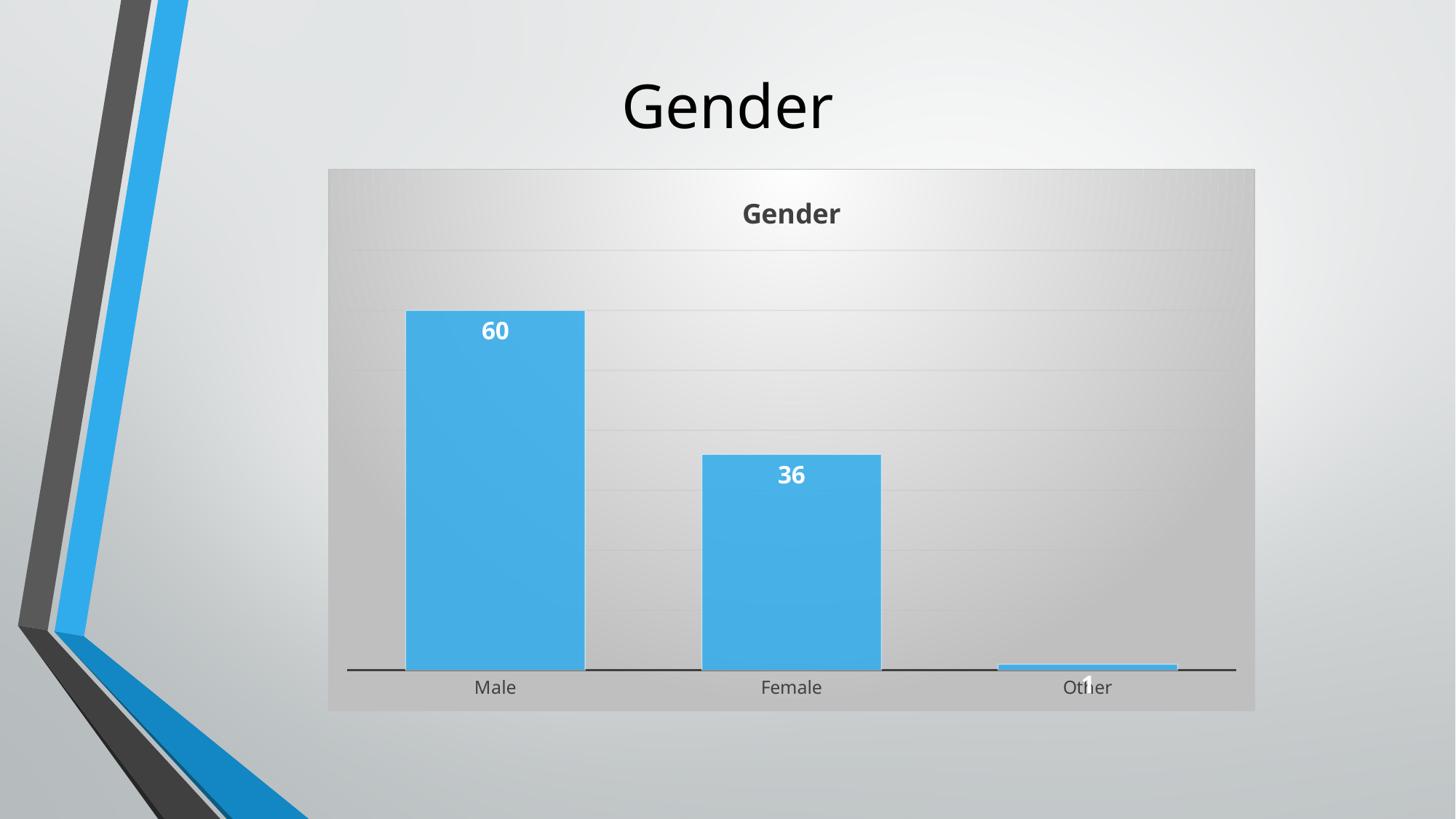
What is the difference between the values for Male and Female? 24 Which category has the highest value? Male Do the values rise or fall from left to right across the categories? Fall What colour are the bars in the chart? Blue How many categories are shown on the x axis? 3 Which is larger, the value for Male or the value for Female? Male What is the title of the chart? Gender What is the value for Female? 36 Which category has the lowest value? Other Which is larger, the value for Female or the value for Other? Female What is the value for Male? 60 What kind of chart is shown? Bar chart